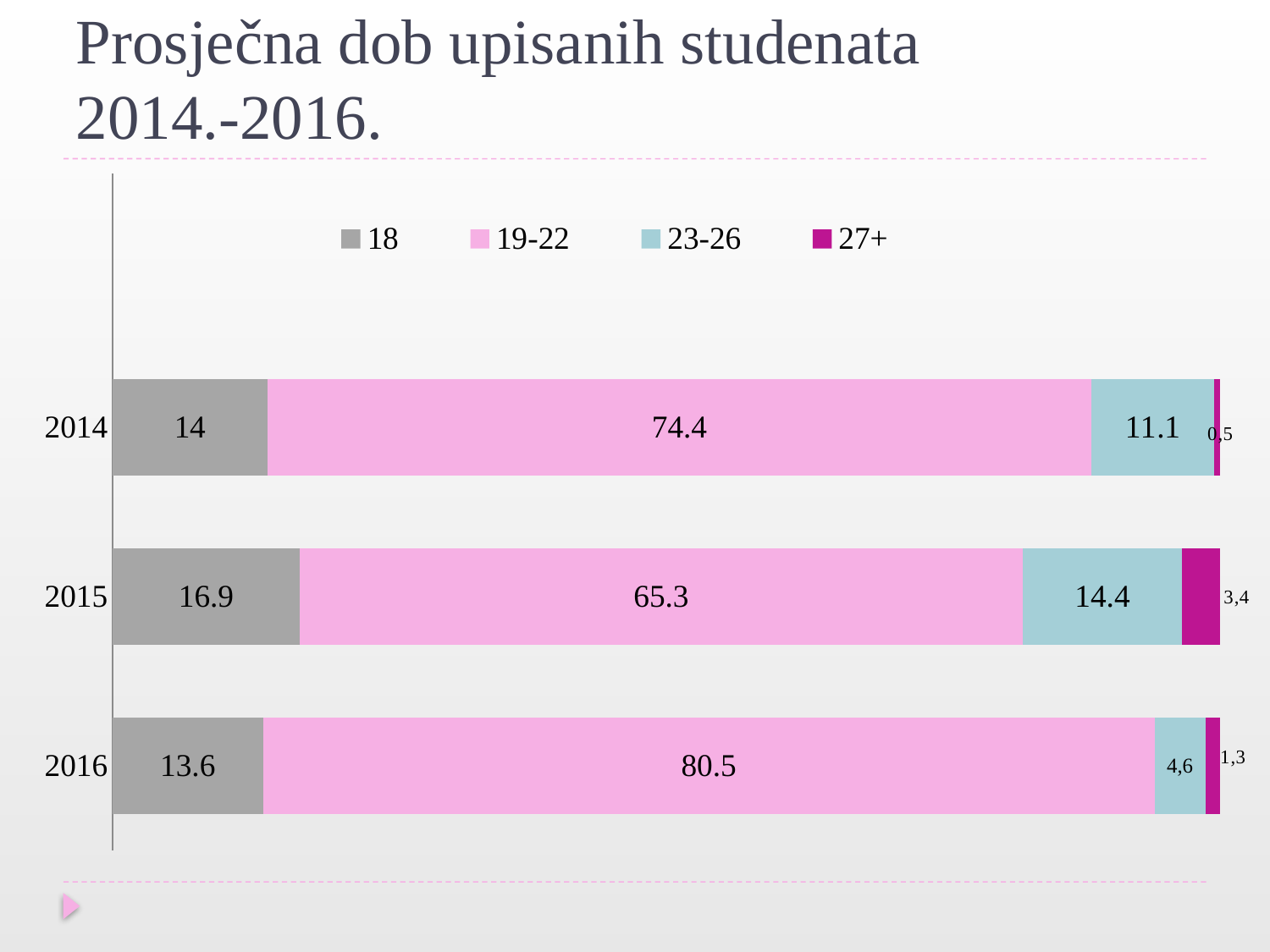
What is the value for the 18 series in 2015? 16.9 What is the value for the 23-26 series in 2016? 4,6 What is the value for the 19-22 series in 2014? 74.4 What kind of chart is shown on the slide? Stacked bar chart How many series does the legend list? 4 What is the value for the 27+ series in 2015? 3,4 How many years are shown on the chart? 3 Which year has the highest value for the 19-22 series? 2016 What is the difference between the 19-22 values for 2016 and 2015? 15.2 Which is larger, the 18 value for 2014 or for 2016? 2014 What is the total of the stacked bar for 2015? 100 Which year has the lowest value for the 23-26 series? 2016